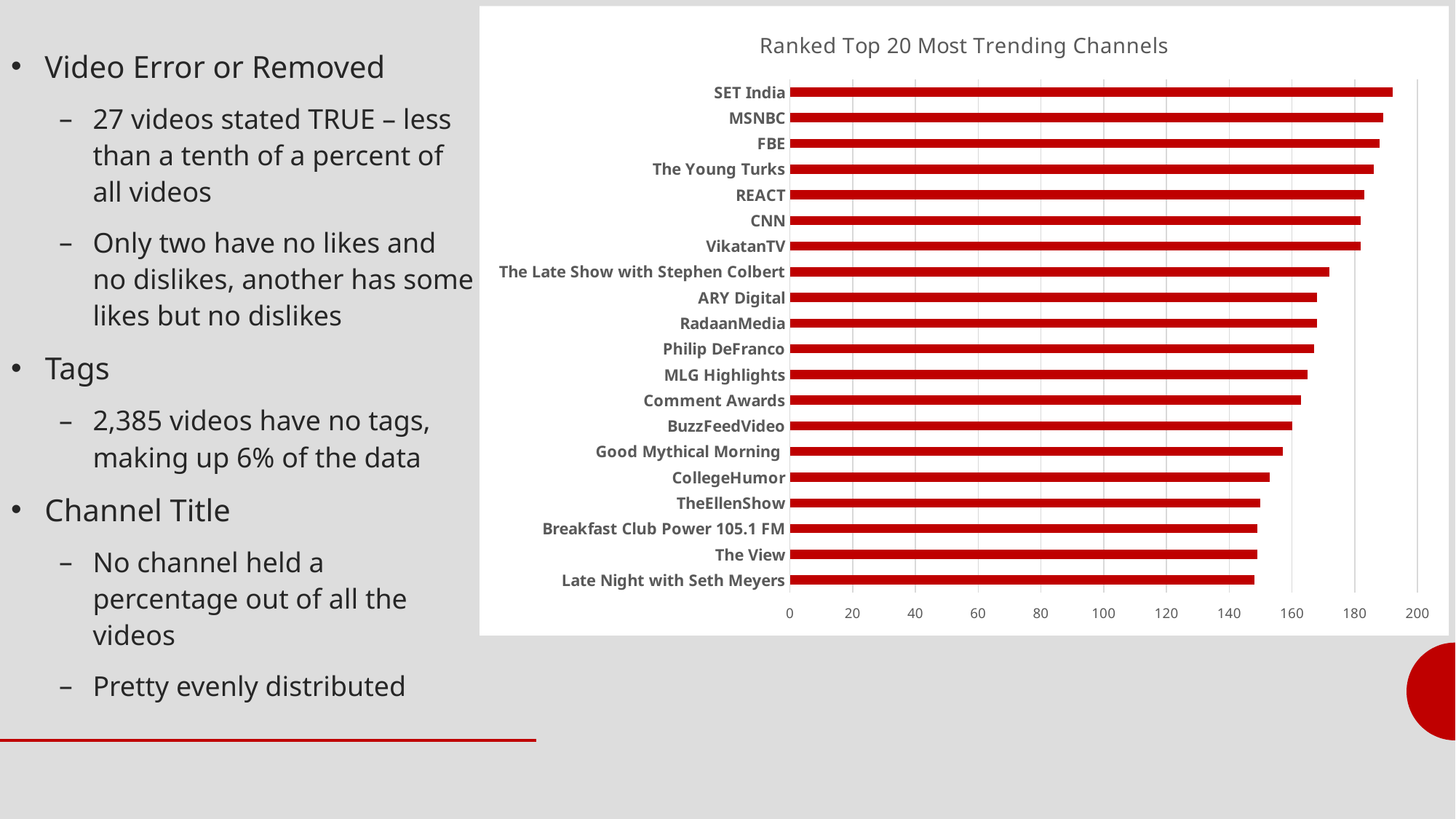
Is the value for CollegeHumor greater or less than 160? less Is the value for SET India greater or less than 180? greater How many channels are plotted in the chart? 20 What is the title of the chart? Ranked Top 20 Most Trending Channels Do the bar values increase or decrease going from the top of the chart to the bottom? decrease What kind of chart is shown on the slide? bar chart Is the value for The Late Show with Stephen Colbert greater or less than 160? greater Which has a larger value, CNN or TheEllenShow? CNN Which has a larger value, The Late Show with Stephen Colbert or CollegeHumor? The Late Show with Stephen Colbert Which channel has the highest value in the chart? SET India